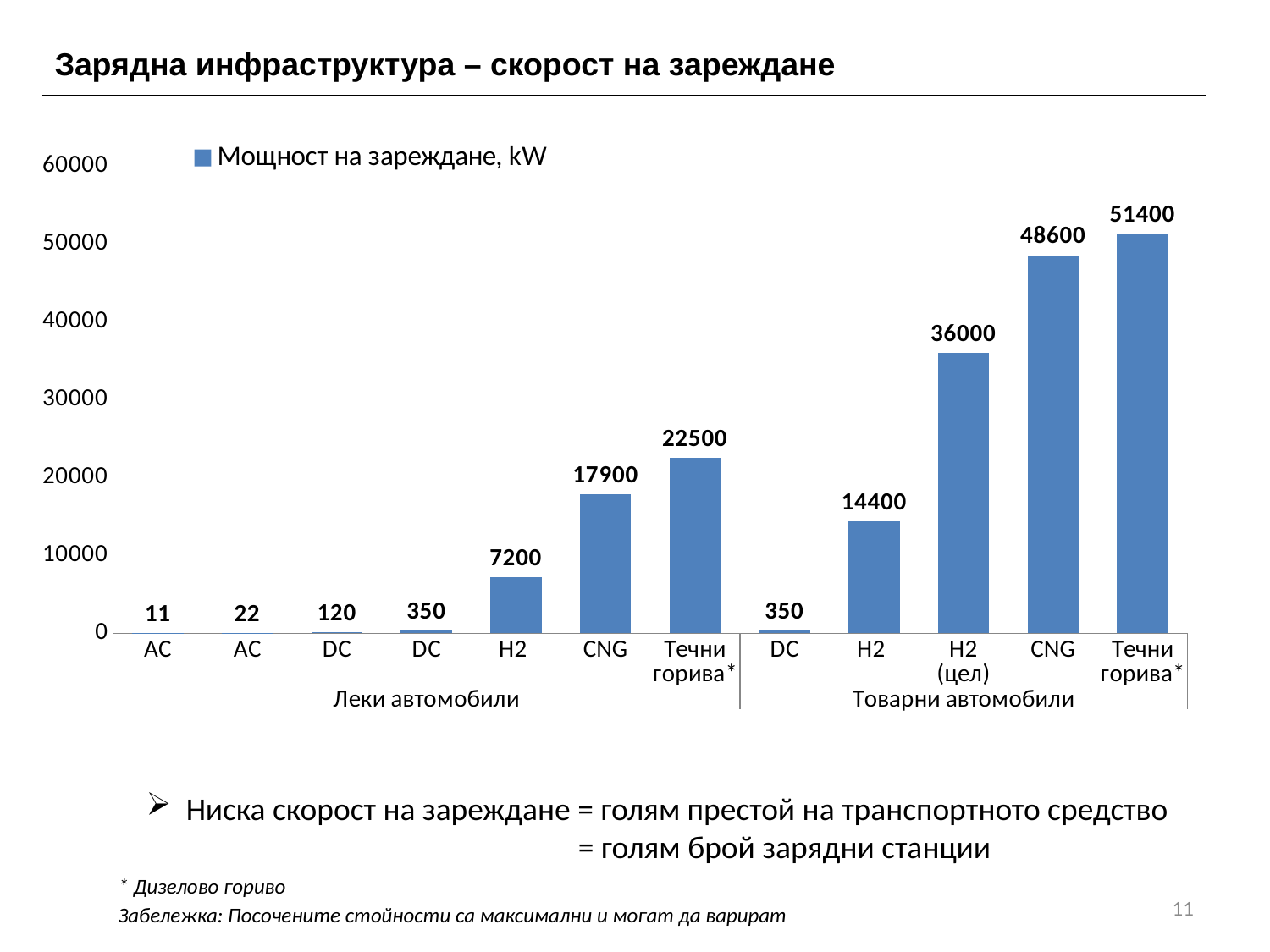
Which category has the highest value in the chart? Течни горива* (Товарни автомобили) What is the value for Течни горива* in the Леки автомобили group? 22500 What is the difference between the Течни горива* value for Товарни автомобили and the CNG value for Товарни автомобили? 2800 Is the value for CNG in the Товарни автомобили group greater or less than 40000? greater How many bars are plotted in the chart? 12 Which category has the lowest value in the chart? the first AC bar (Леки автомобили) What type of chart is shown on the slide? bar chart What is the value for H2 (цел) in the Товарни автомобили group? 36000 What is the charging power value for CNG in the Леки автомобили group? 17900 Which is larger: the H2 value for Леки автомобили or the H2 value for Товарни автомобили? H2 for Товарни автомобили What is the value for H2 in the Товарни автомобили group? 14400 What is the name of the series shown in the legend? Мощност на зареждане, kW